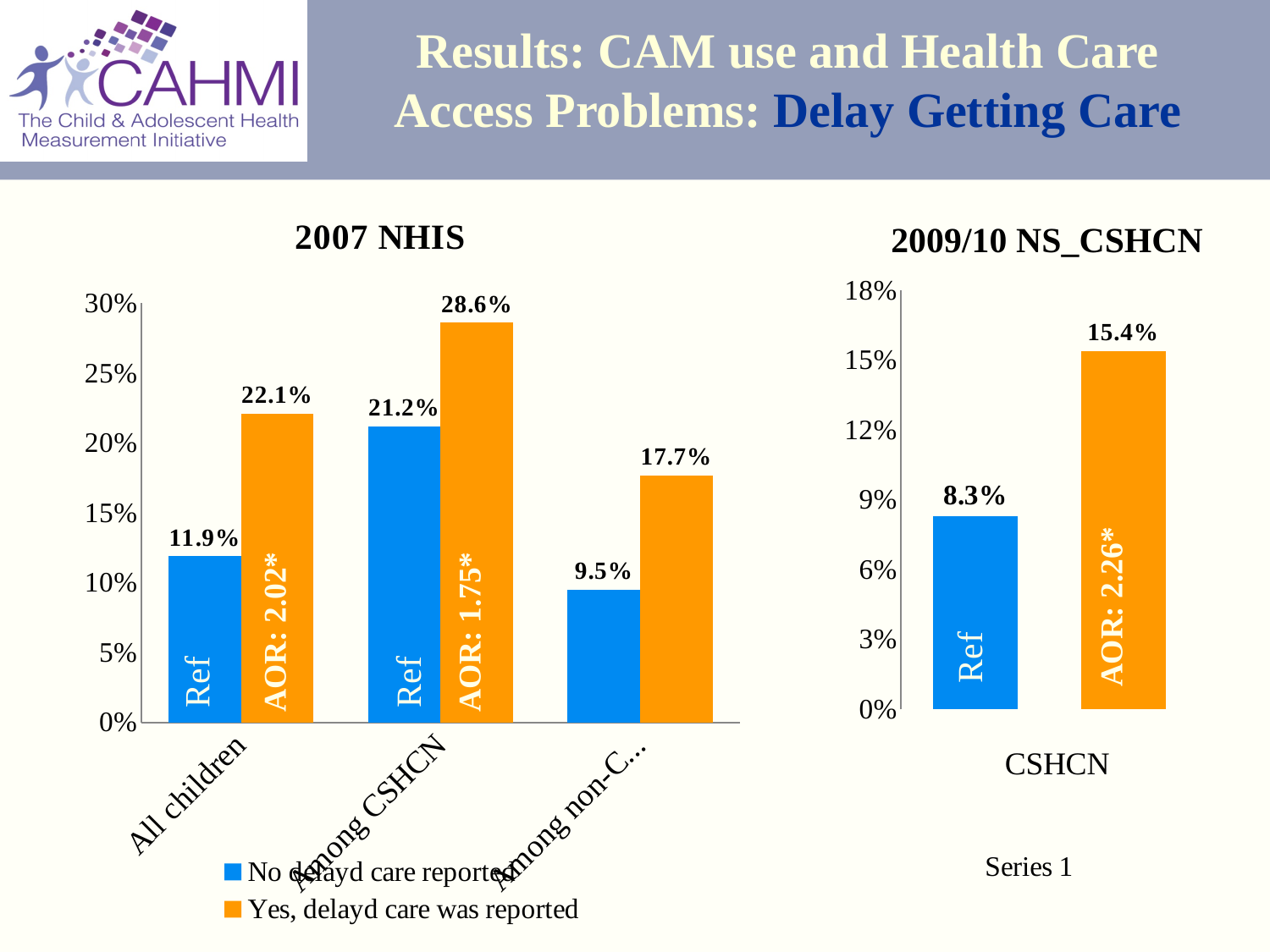
In the 2009/10 NS_CSHCN chart, what is the value of the orange bar for CSHCN? 15.4% In the 2007 NHIS chart, what is the value for All children in the 'Yes, delayd care was reported' series? 22.1% In the 2009/10 NS_CSHCN chart, is the value of the blue bar greater or less than 9%? less How many series does the legend of the 2007 NHIS chart list? 2 In the 2007 NHIS chart, what is the difference between the two bars for All children? 10.2 percentage points In the 2007 NHIS chart, which bar has the highest value? Among CSHCN, Yes, delayd care was reported (28.6%) What kind of chart is the 2009/10 NS_CSHCN chart? Bar chart How many categories are shown on the x axis of the 2007 NHIS chart? 3 In the 2009/10 NS_CSHCN chart, what AOR label is printed on the orange bar? AOR: 2.26* In the 2009/10 NS_CSHCN chart, what is the difference between the orange bar and the blue bar? 7.1 percentage points In the 2007 NHIS chart, what is the value for Among CSHCN in the 'No delayd care reported' series? 21.2% In the 2007 NHIS chart, which is larger: the 'No delayd care reported' value for Among CSHCN or the 'Yes, delayd care was reported' value for All children? Yes, delayd care was reported for All children (22.1%)